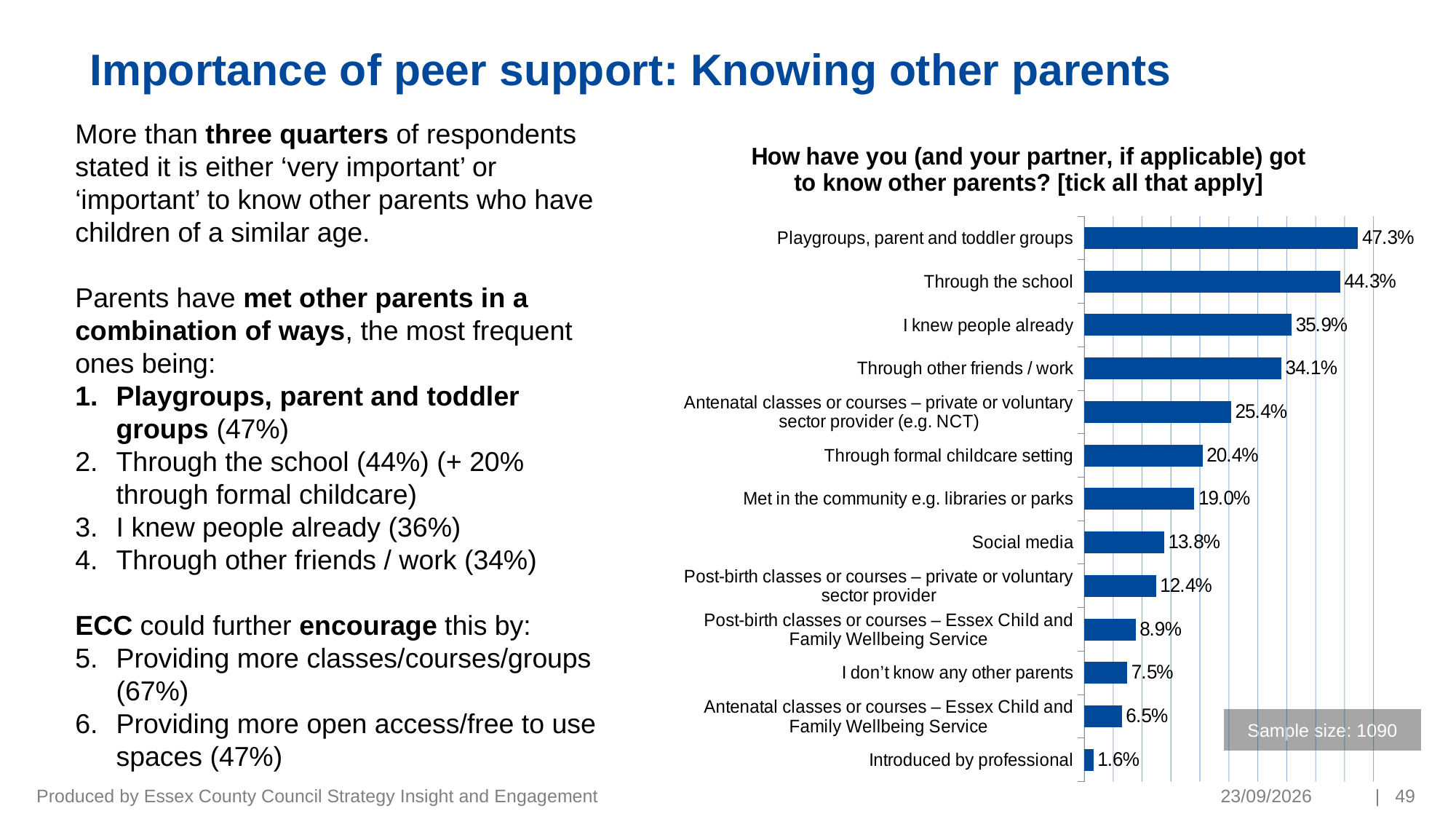
What is the difference between 'I knew people already' and 'Through other friends / work'? 1.8% What percentage of respondents met other parents in the community e.g. libraries or parks? 19.0% How many categories are shown in the chart? 13 What is the difference between 'Playgroups, parent and toddler groups' and 'Through the school'? 3.0% What type of chart is shown on the slide? Bar chart What percentage of respondents got to know other parents through playgroups, parent and toddler groups? 47.3% What is the value for 'Social media'? 13.8% What is the sample size stated on the chart? 1090 Which is larger: 'Through formal childcare setting' or 'Met in the community e.g. libraries or parks'? Through formal childcare setting Which category has the lowest value in the chart? Introduced by professional Which category has the highest value in the chart? Playgroups, parent and toddler groups What is the value for 'Through the school'? 44.3%